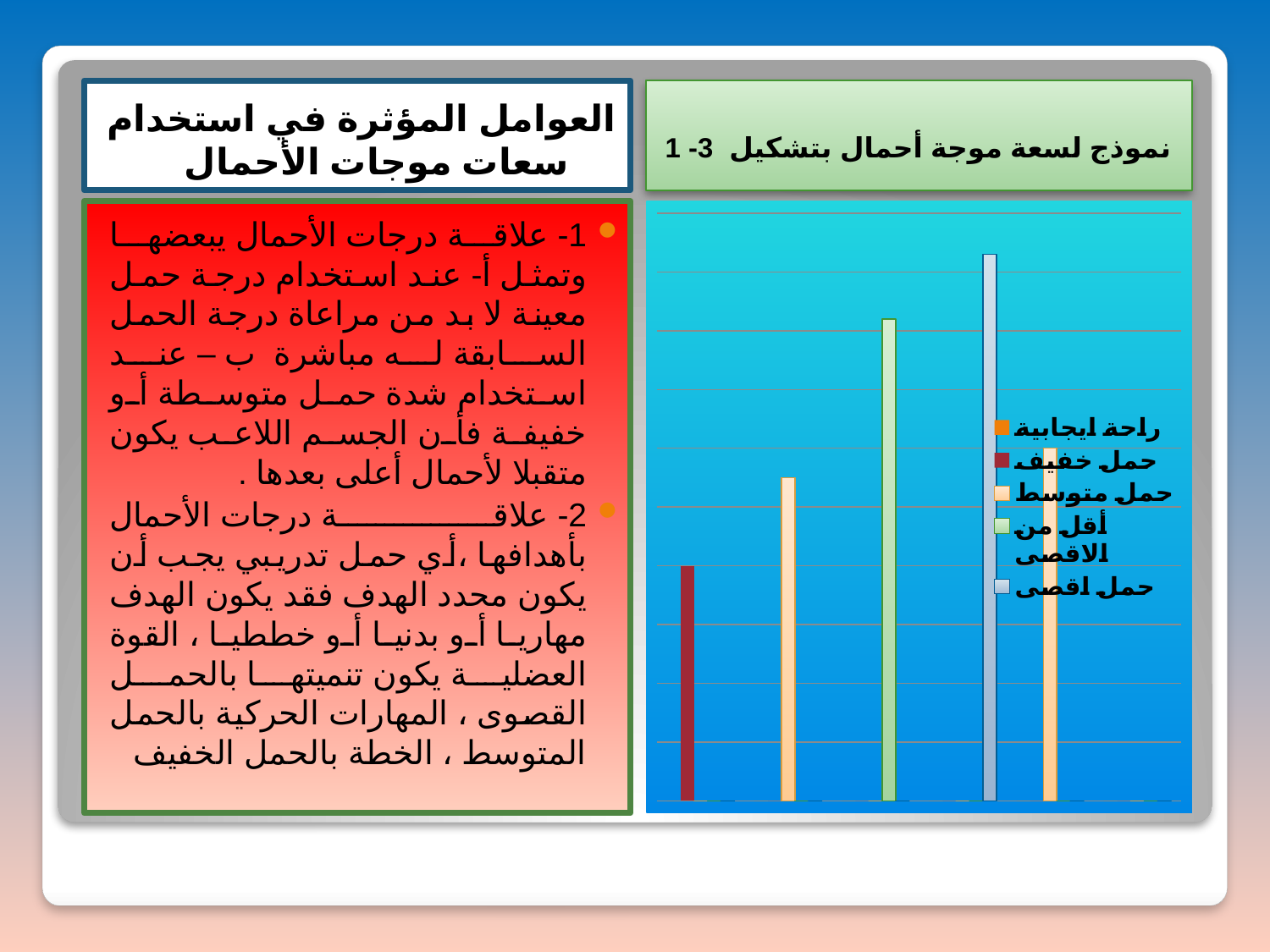
What colour is the legend marker for حمل اقصى? light blue Do the bar heights rise or fall from the first bar to the fourth bar along the x axis? rise Does the last bar in the chart rise or fall compared with the bar immediately before it? fall How many bars are visible in the chart? 5 What is the title shown above the chart? نموذج لسعة موجة أحمال بتشكيل 3-1 How many entries does the chart's legend list? 5 Which legend series has the tallest bar in the chart? حمل اقصى Which legend series has the shortest visible bar in the chart? حمل خفيف Which bar is taller: the one for حمل خفيف or the one for حمل متوسط? حمل متوسط What kind of chart is shown on the slide? bar chart Which bar is taller: the one for أقل من الاقصى or the one for حمل متوسط? أقل من الاقصى